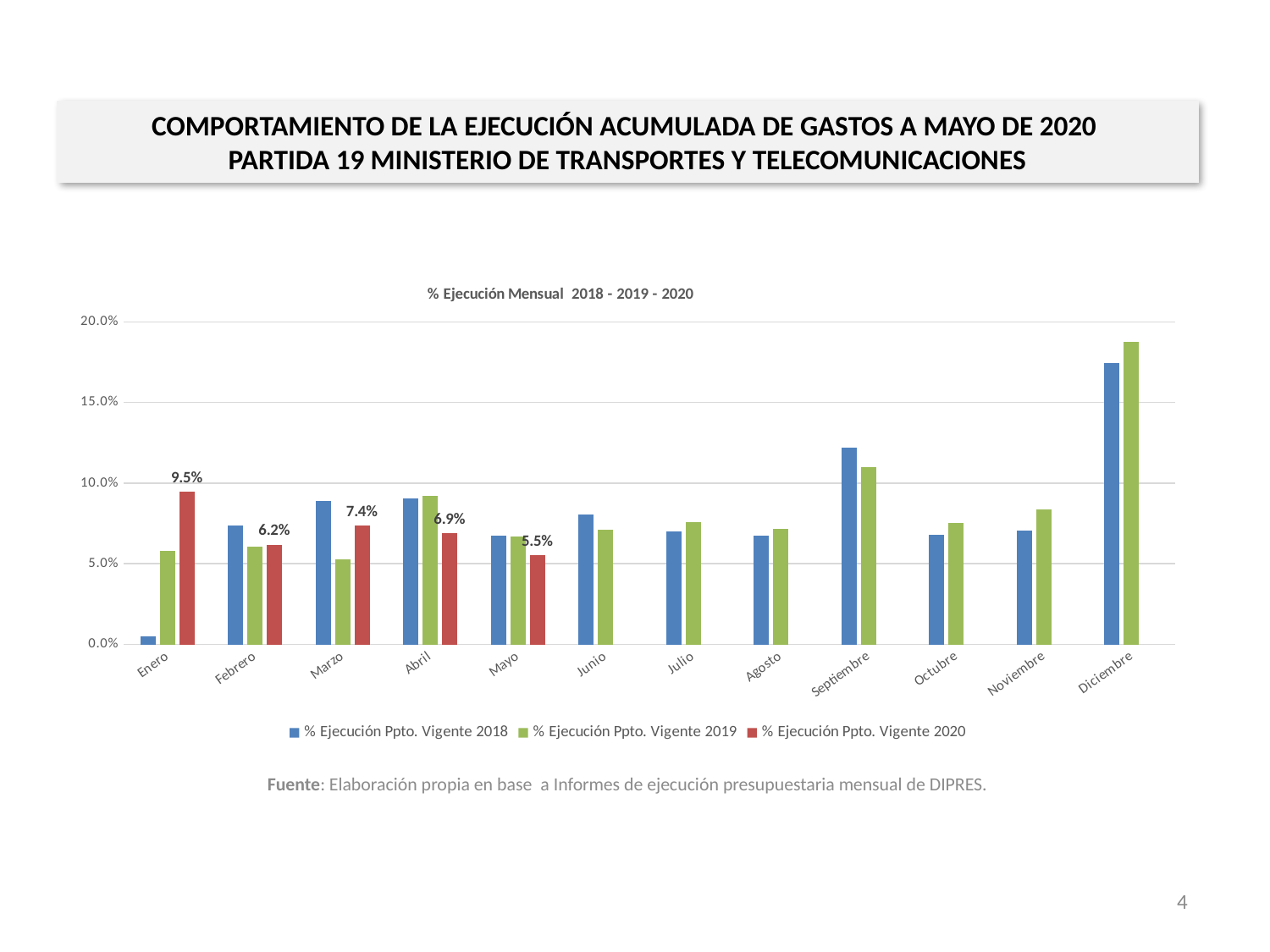
Which month has the highest value for % Ejecución Ppto. Vigente 2020? Enero What kind of chart is shown on the slide? Bar chart Which month has the lowest value for % Ejecución Ppto. Vigente 2020? Mayo Is the value for % Ejecución Ppto. Vigente 2019 in Diciembre greater or less than 15.0%? greater What is the difference between the 2020 values for Enero and Mayo? 4.0% How many series does the legend list? 3 Which is larger for % Ejecución Ppto. Vigente 2020: Marzo or Abril? Marzo What is the difference between the 2020 values for Marzo and Febrero? 1.2% How many months are shown on the x axis of the chart? 12 What is the value for % Ejecución Ppto. Vigente 2020 in Mayo? 5.5% What is the value for % Ejecución Ppto. Vigente 2020 in Enero? 9.5% Is the value for % Ejecución Ppto. Vigente 2018 in Enero greater or less than 5.0%? less